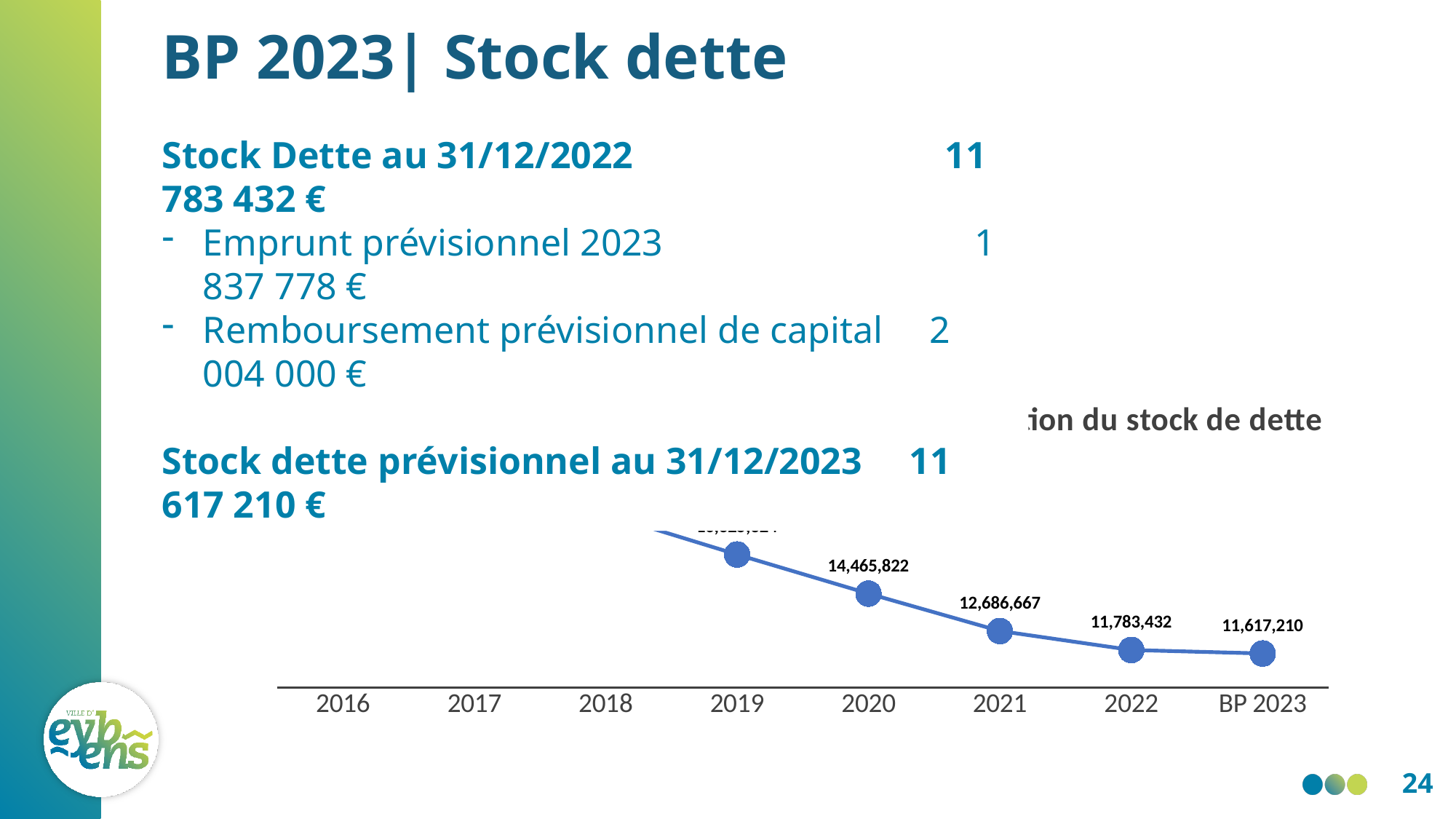
What is the difference between the values for 2021 and 2022? 903,235 What is the value for 2022 on the chart? 11,783,432 Which is larger, the value for 2020 or the value for 2021? 2020 What is the value for 2020 on the chart? 14,465,822 What is the difference between the values for 2020 and 2021? 1,779,155 How many categories are shown on the x axis of the chart? 8 What is the value for BP 2023 on the chart? 11,617,210 What is the difference between the values for 2022 and BP 2023? 166,222 What kind of chart is shown on the slide? line chart Do the values rise or fall from 2019 to BP 2023? fall Which category has the lowest value on the chart? BP 2023 What is the value for 2021 on the chart? 12,686,667